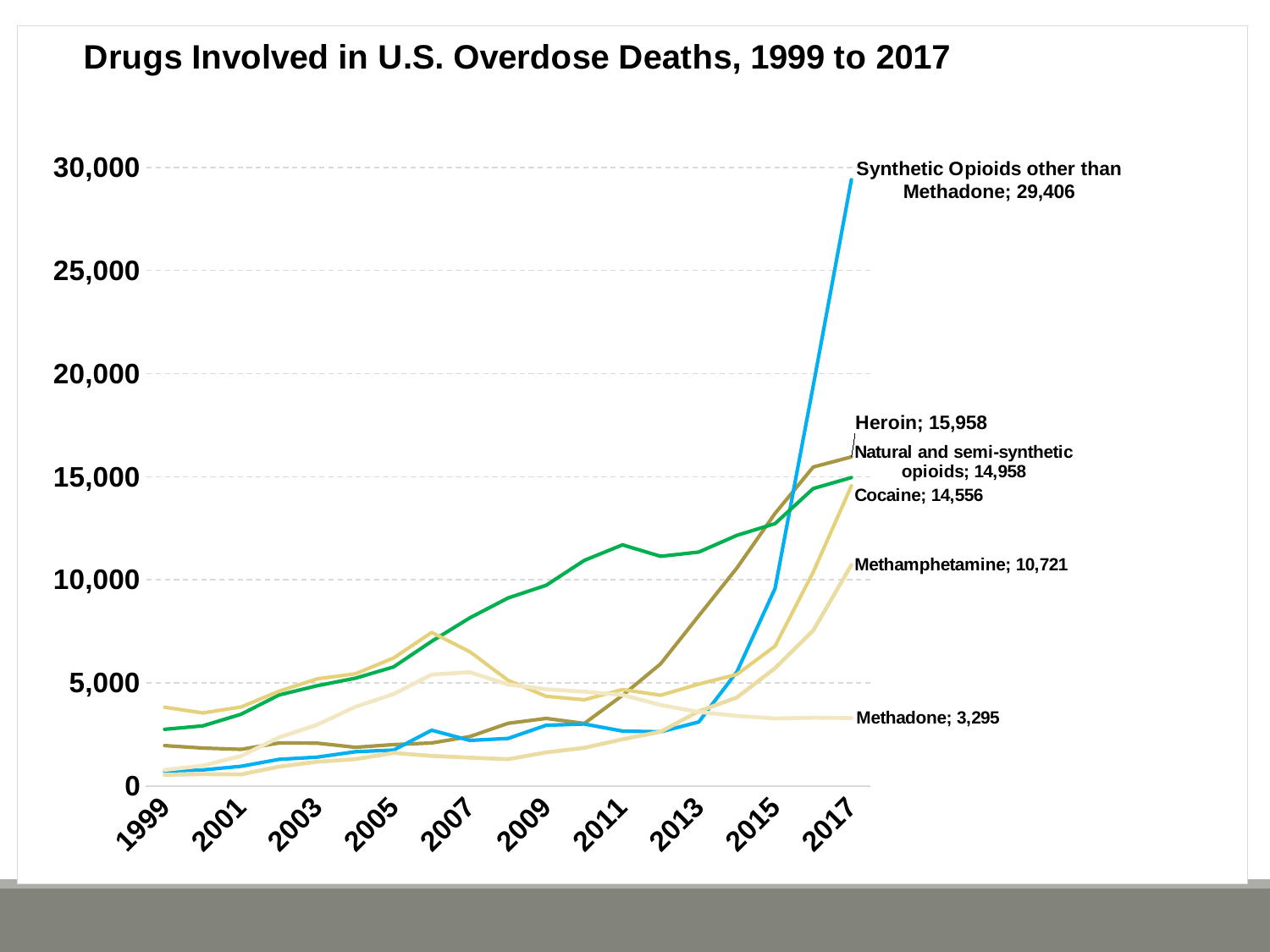
What is the 2017 value for Synthetic Opioids other than Methadone? 29,406 What is the difference between the 2017 values for Heroin and Cocaine? 1,402 Which drug has the lowest value in 2017? Methadone How many drug series are plotted on the chart? 6 What kind of chart is shown on the slide? line chart What is the 2017 value for Heroin? 15,958 In 2017, which is larger: Natural and semi-synthetic opioids or Cocaine? Natural and semi-synthetic opioids Does the Synthetic Opioids other than Methadone line rise or fall between 2013 and 2017? rise What is the title of the chart? Drugs Involved in U.S. Overdose Deaths, 1999 to 2017 Which drug has the highest value in 2017? Synthetic Opioids other than Methadone What is the 2017 value for Methamphetamine? 10,721 What is the 2017 value for Methadone? 3,295